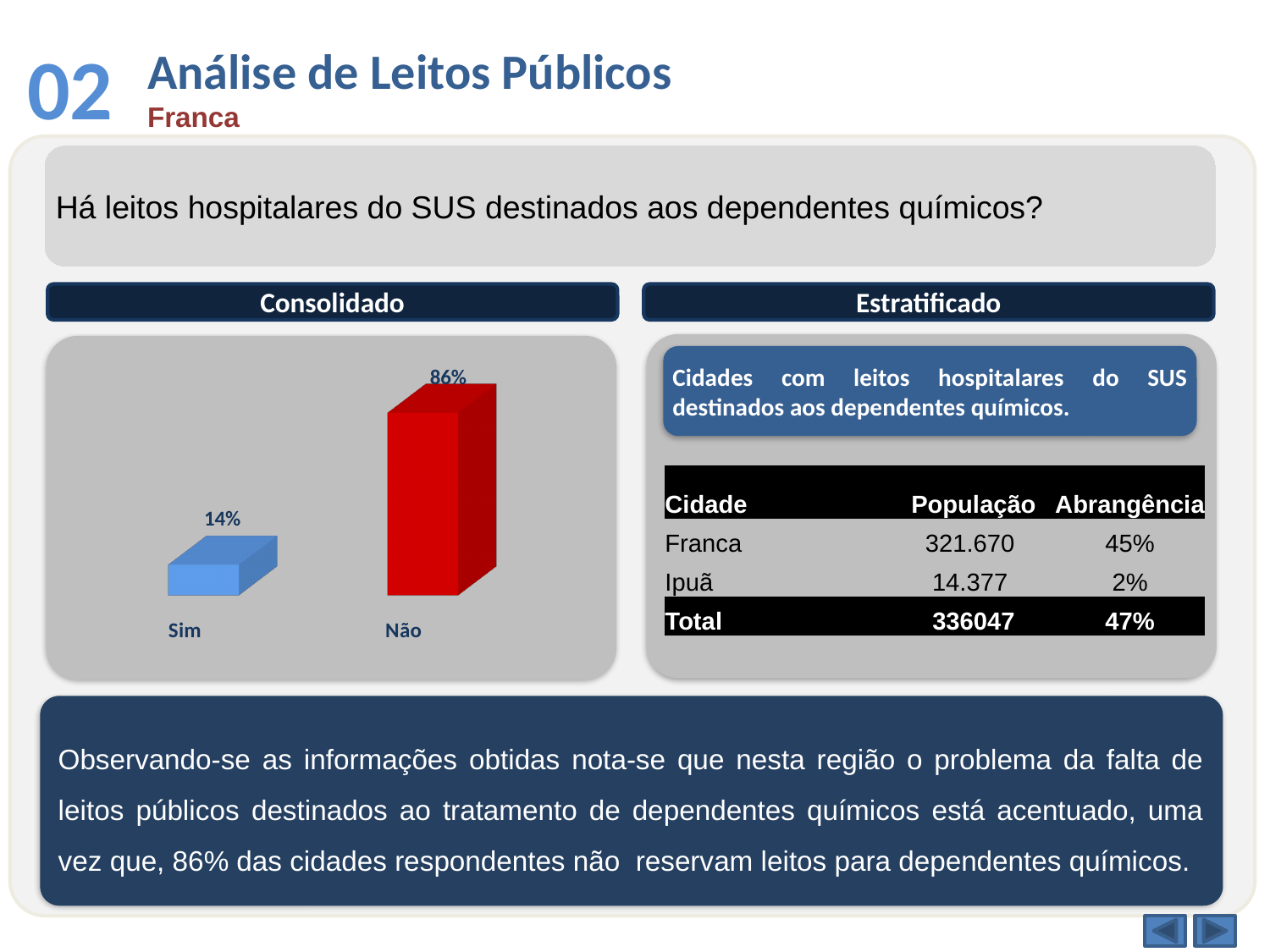
What is the difference between the values for "Não" and "Sim" in the bar chart? 72% Which category has the highest value in the bar chart? Não What is the total of the two values shown in the bar chart? 100% What colour is the bar for "Não" in the bar chart? Red How many categories are shown in the bar chart? 2 What is the value for "Sim" in the bar chart? 14% Which is larger in the bar chart, the value for "Sim" or the value for "Não"? Não Which category has the lowest value in the bar chart? Sim What colour is the bar for "Sim" in the bar chart? Blue What is the value for "Não" in the bar chart? 86% What kind of chart is shown under the "Consolidado" heading? Bar chart